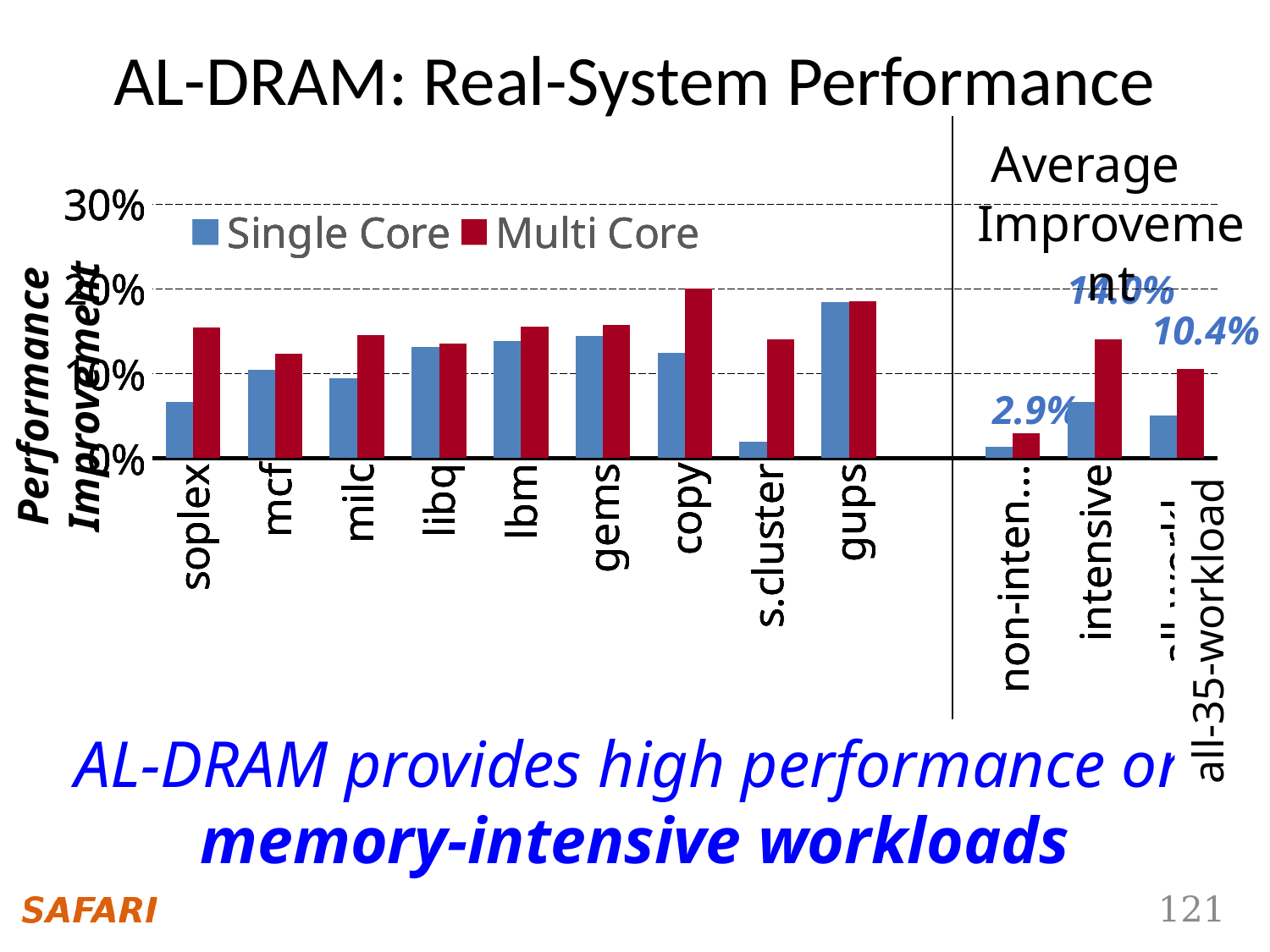
Is the Single Core value for s.cluster greater or less than 10%? less Among the nine benchmarks left of the divider line, which has the lowest Single Core value? s.cluster Which category has the highest Single Core value? gups For soplex, which is larger: the Single Core value or the Multi Core value? Multi Core What are the two series named in the legend? Single Core and Multi Core Is the Single Core value for soplex greater or less than 10%? less What kind of chart is shown on the slide? bar chart Is the Single Core value for gups greater or less than 10%? greater Which colour represents the Multi Core series? red For s.cluster, which is larger: the Single Core value or the Multi Core value? Multi Core How many series does the legend list? 2